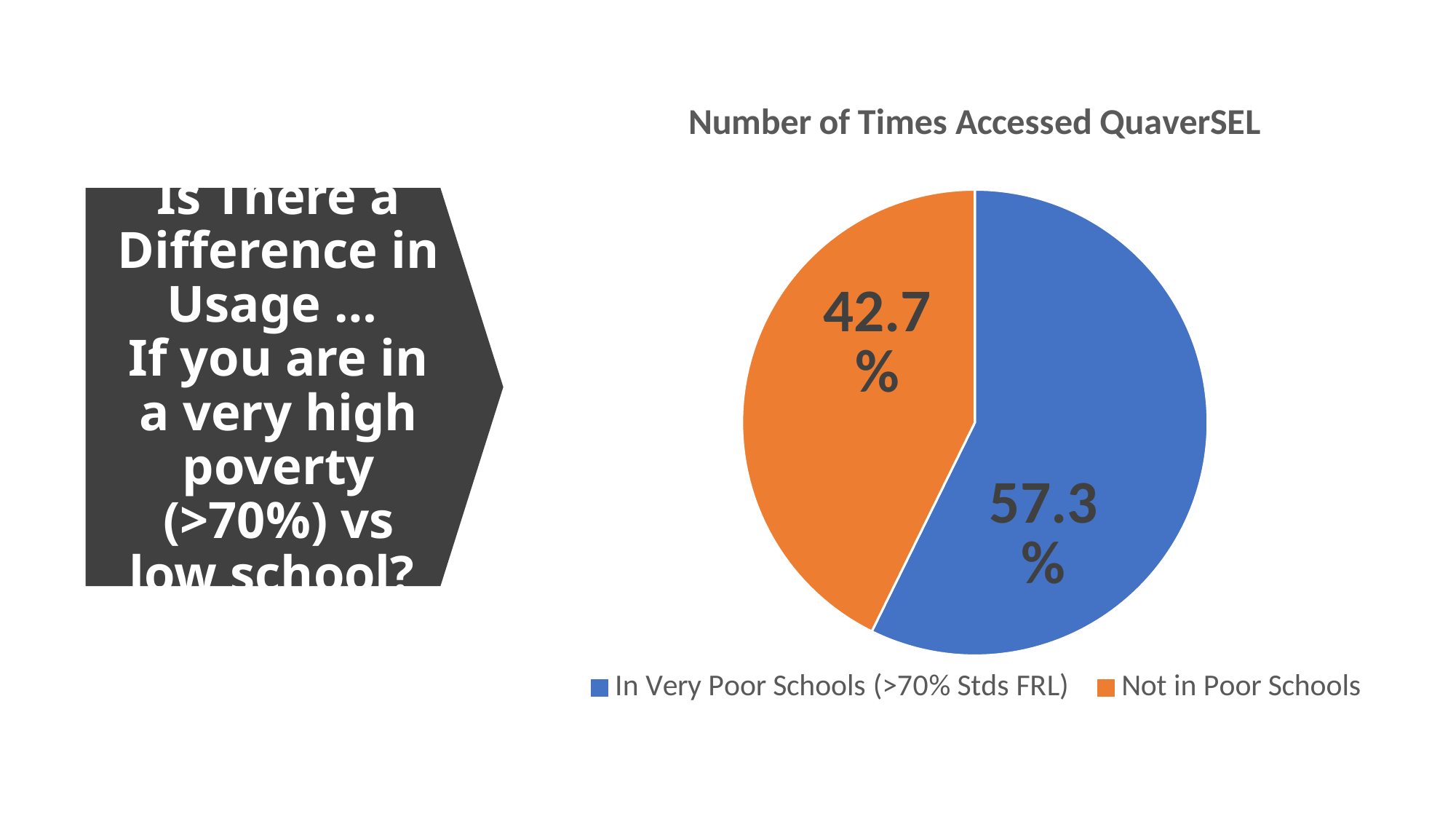
What share of the pie is labelled for Not in Poor Schools? 42.7% What share of the pie is labelled for In Very Poor Schools (>70% Stds FRL)? 57.3% How many slices does the pie chart have? 2 Which slice is larger: In Very Poor Schools (>70% Stds FRL) or Not in Poor Schools? In Very Poor Schools (>70% Stds FRL) Which category has the largest slice of the pie? In Very Poor Schools (>70% Stds FRL) Is the share for In Very Poor Schools (>70% Stds FRL) greater or less than 50%? greater What is the difference in percentage points between the In Very Poor Schools slice and the Not in Poor Schools slice? 14.6 What is the title of the chart? Number of Times Accessed QuaverSEL What colour is the slice for Not in Poor Schools? orange How many entries does the legend list? 2 Which category has the smallest slice of the pie? Not in Poor Schools What kind of chart is shown on the slide? pie chart